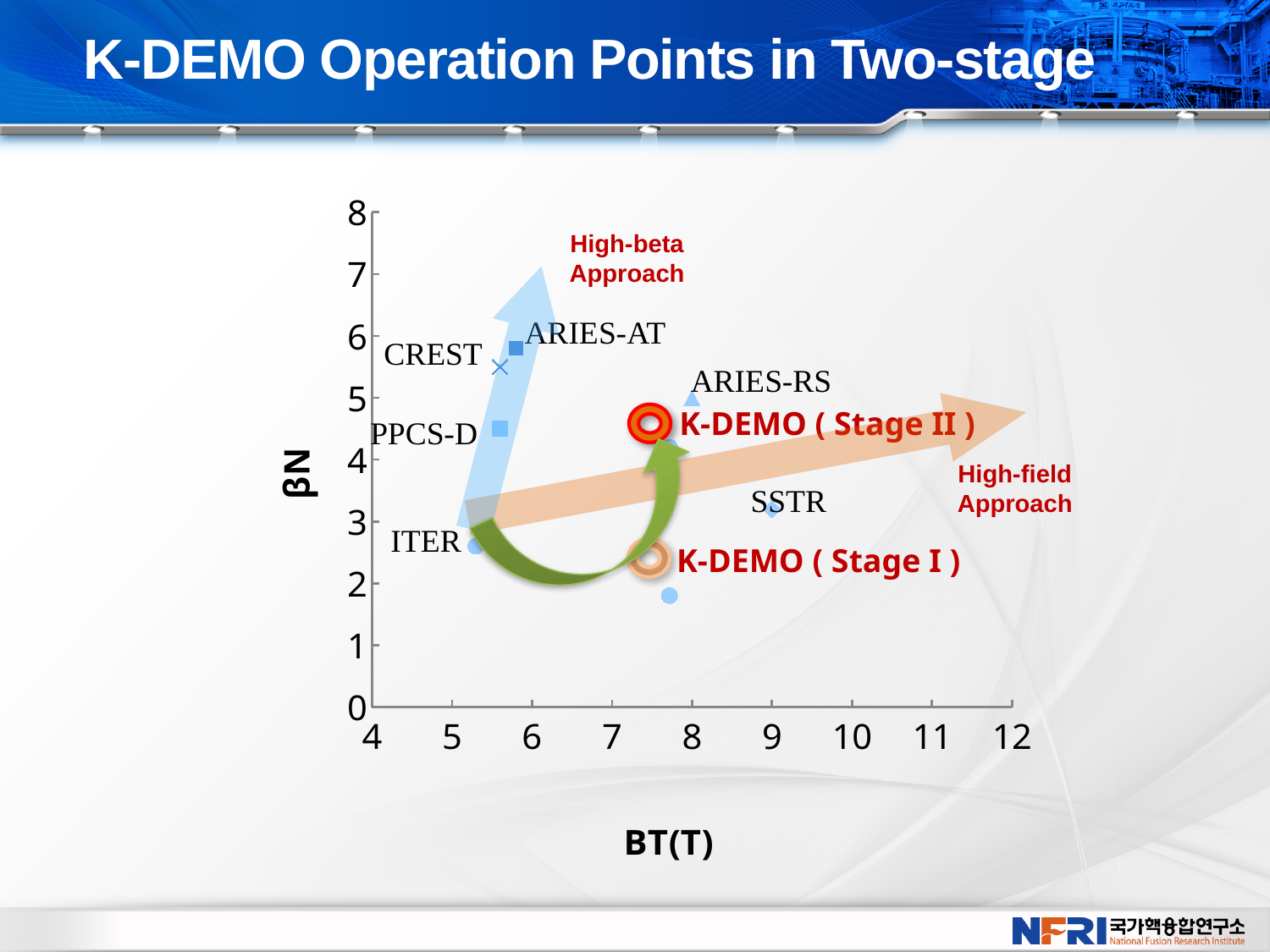
What is the label of the y axis? βN Is the BT(T) value for SSTR greater or less than 8? greater What kind of chart is shown on the slide? scatter chart Which has the larger βN value, K-DEMO ( Stage II ) or K-DEMO ( Stage I )? K-DEMO ( Stage II ) Which labeled point has the highest βN value? ARIES-AT Is the βN value for K-DEMO ( Stage I ) greater or less than 3? less Which has the larger BT(T) value, SSTR or ITER? SSTR Is the βN value for ARIES-AT greater or less than 5? greater What is the label of the x axis? BT(T) Which labeled point has the highest BT(T) value? SSTR